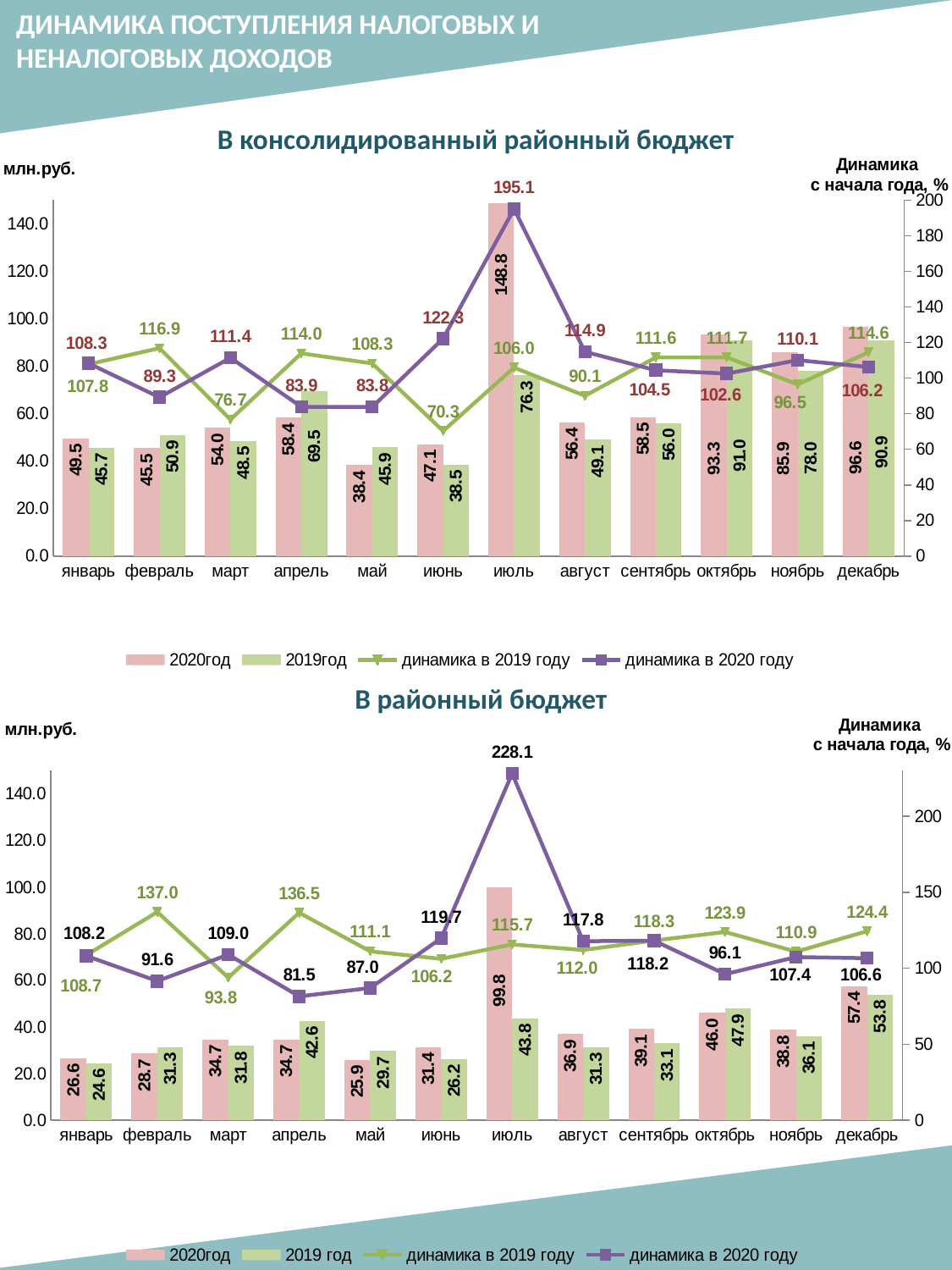
In the chart 'В районный бюджет', what is the 2019 год value for октябрь? 47.9 What kind of chart is 'В районный бюджет'? Combined bar and line chart In the chart 'В районный бюджет', what is the 'динамика в 2020 году' value for июль? 228.1 In the chart 'В консолидированный районный бюджет', which month has the lowest 2020год bar? май In the chart 'В консолидированный районный бюджет', what is the 'динамика в 2020 году' value for июнь? 122.3 In the chart 'В консолидированный районный бюджет', what is the 2020год value for июль? 148.8 In the chart 'В районный бюджет', what is the difference between the 2020год and 2019 год values for июль? 56.0 In the chart 'В консолидированный районный бюджет', which is larger for апрель: the 2020год bar or the 2019год bar? 2019год How many months are shown on the x axis of the chart 'В районный бюджет'? 12 In the chart 'В консолидированный районный бюджет', which month has the highest 2020год bar? июль In the chart 'В консолидированный районный бюджет', what is the difference between the 2020год and 2019год values for декабрь? 5.7 How many series does the legend of the chart 'В консолидированный районный бюджет' list? 4